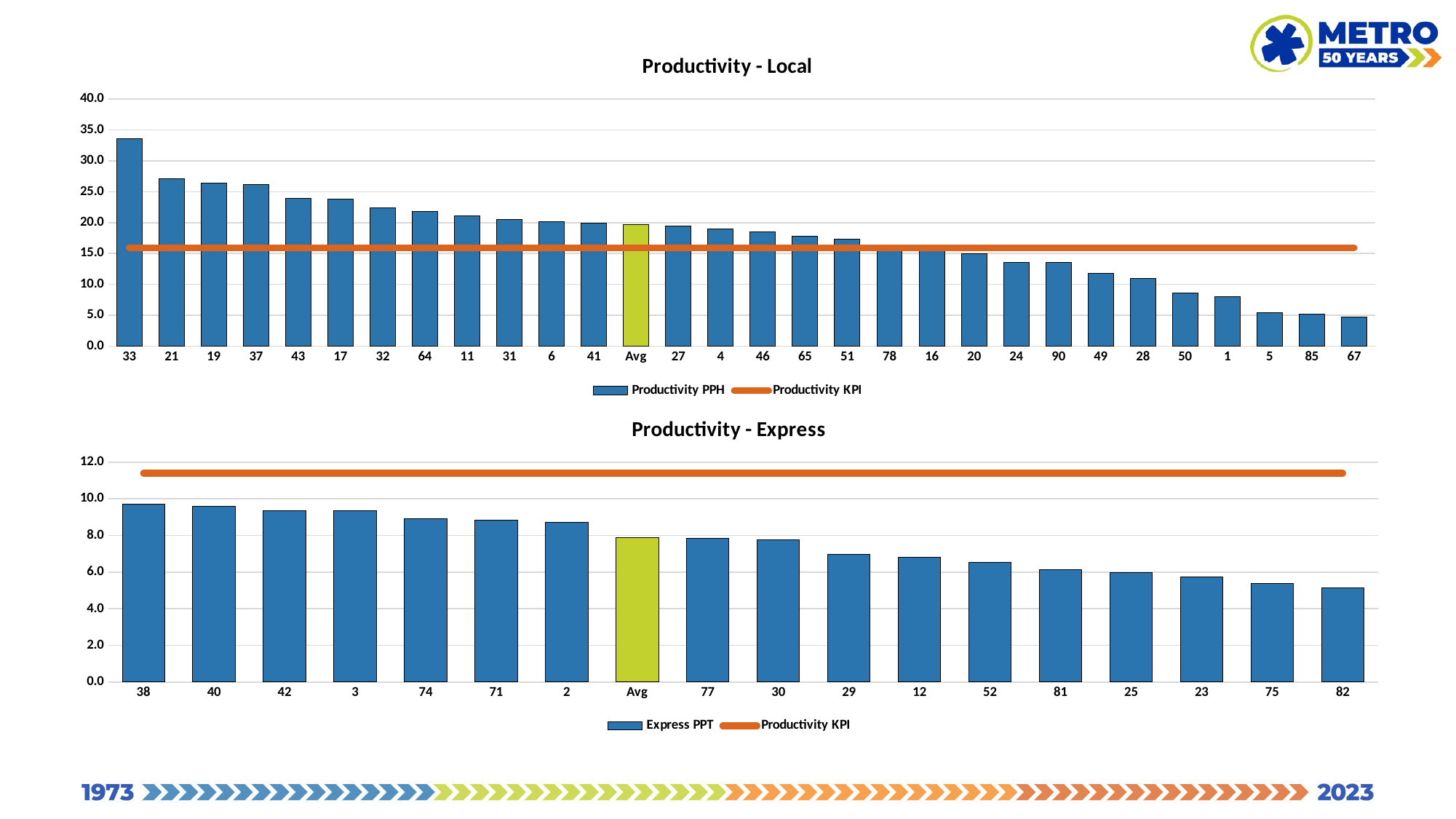
In the 'Productivity - Local' chart, which category has the highest Productivity PPH? 33 In the 'Productivity - Local' chart, is the value for 24 greater or less than 15.0? less In the 'Productivity - Express' chart, how many categories are shown on the x axis? 18 In the 'Productivity - Local' chart, how many categories are shown on the x axis? 30 In the 'Productivity - Express' chart, is the value for 29 greater or less than 8.0? less How many series does the legend of the 'Productivity - Local' chart list? 2 In the 'Productivity - Express' chart, do the Express PPT values rise or fall from left to right? fall What kind of chart is the 'Productivity - Local' chart? bar chart In the 'Productivity - Local' chart, is the value for 33 greater or less than 30.0? greater What is the title of the bottom chart on the slide? Productivity - Express In the 'Productivity - Express' chart, which category has the lowest Express PPT? 82 In the 'Productivity - Local' chart, which category has the lowest Productivity PPH? 67